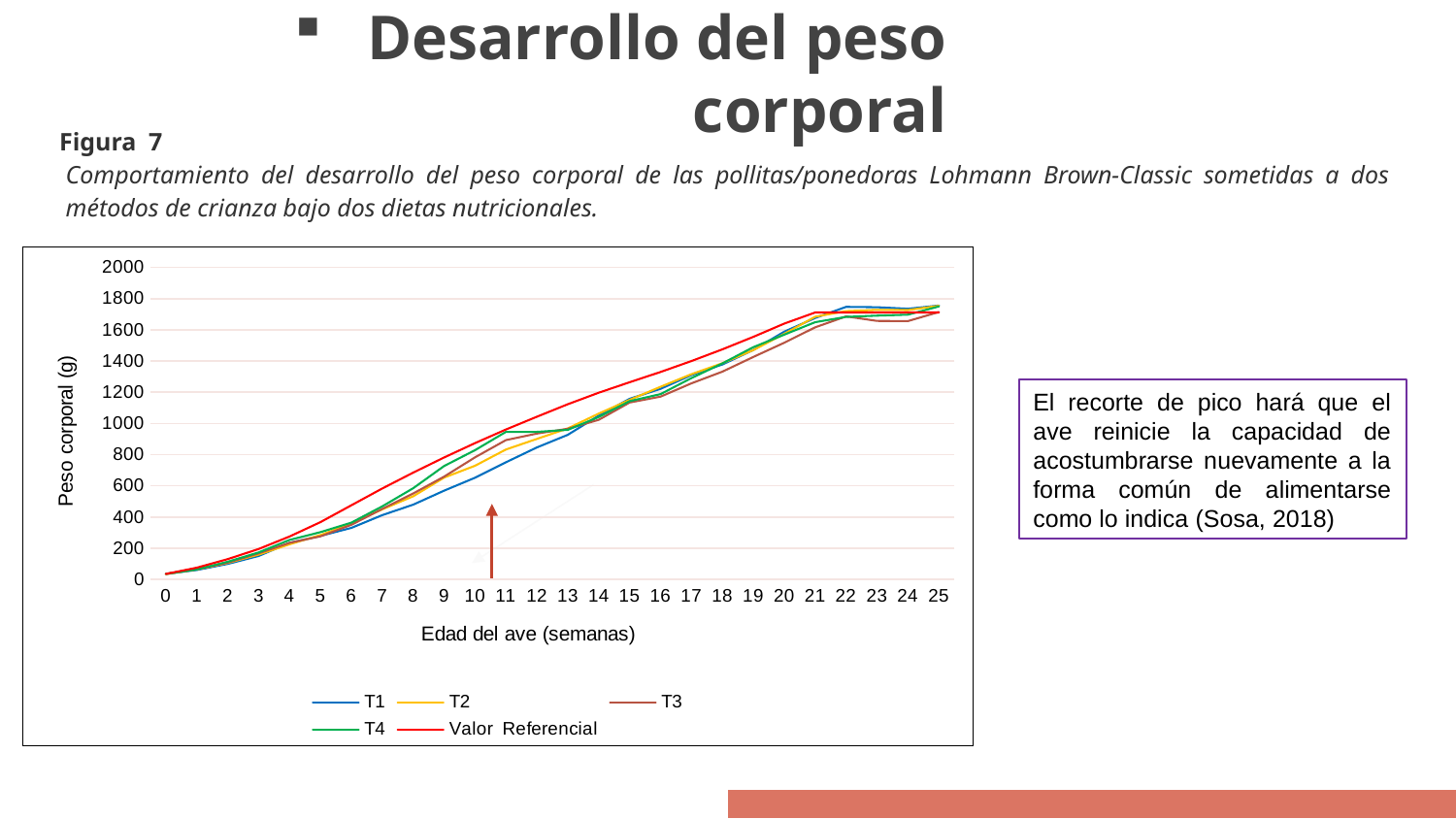
Is the value for Valor Referencial at week 25 greater or less than 1600? greater What kind of chart is shown on the slide? line chart Is the value for T1 at week 5 greater or less than 400? less Do the body weight values rise or fall as the age of the bird increases along the x axis? rise How many series does the chart legend list? 5 Is the value for Valor Referencial at week 15 greater or less than 1000? greater At week 10, which is higher: T1 or Valor Referencial? Valor Referencial Which series are listed in the chart legend? T1, T2, T3, T4, Valor Referencial How many weeks (x-axis points) are plotted on the chart, from 0 to 25? 26 What is the title of the vertical axis of the chart? Peso corporal (g) At week 8, which is higher: T1 or Valor Referencial? Valor Referencial